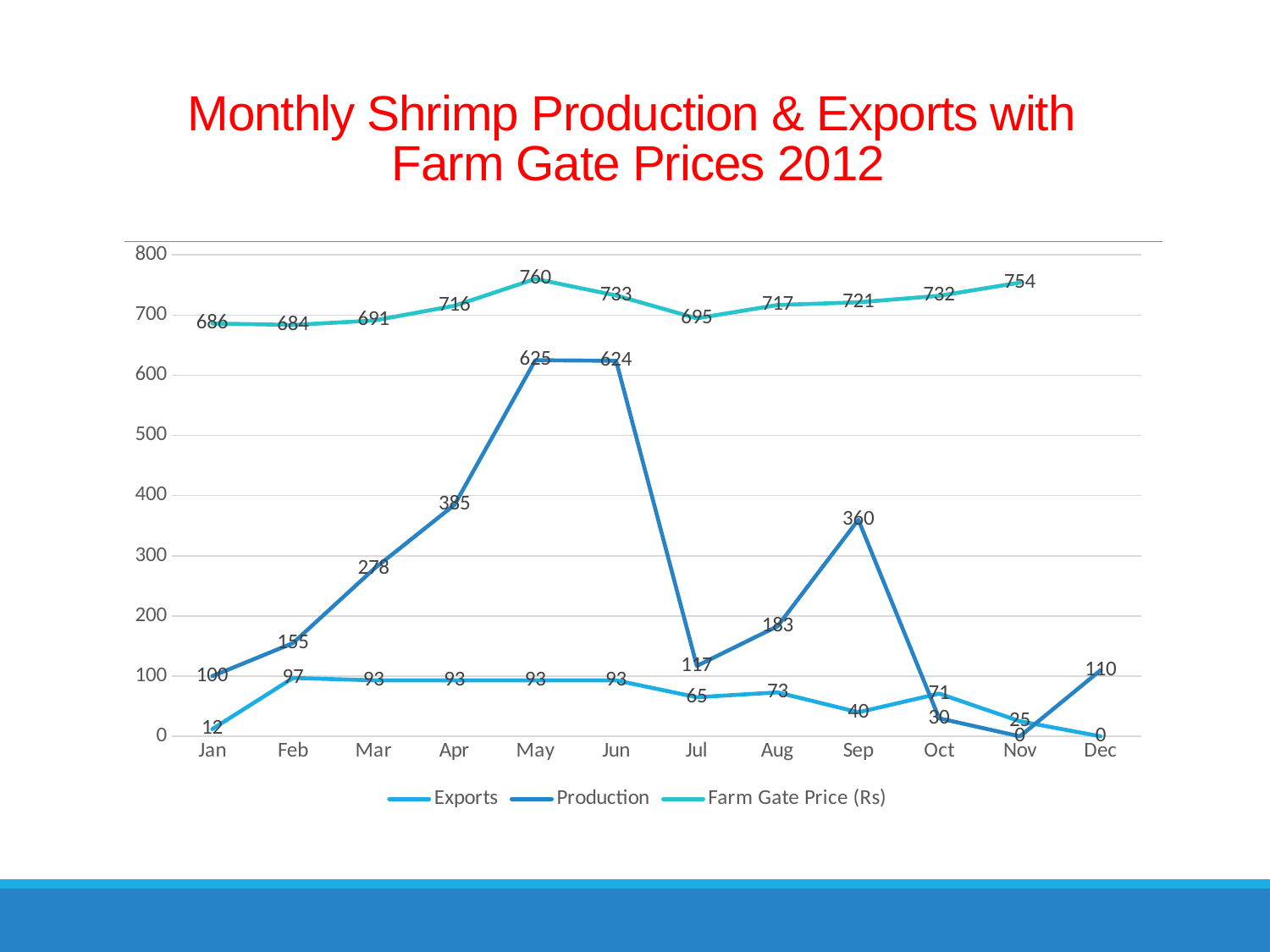
How many months are shown on the x axis? 12 What is the Exports value for Sep? 40 Does the Farm Gate Price (Rs) rise or fall from Jul to Nov? rise What is the difference between Production in Sep and Production in Aug? 177 What is the Farm Gate Price (Rs) for Nov? 754 Which month has the higher Exports value, Feb or Mar? Feb What is the Production value for May? 625 In which month is Production lowest? Nov In which month is the Farm Gate Price (Rs) highest? May What kind of chart is shown on the slide? line chart Is the Production value for Apr greater or less than 400? less How many series does the legend list? 3